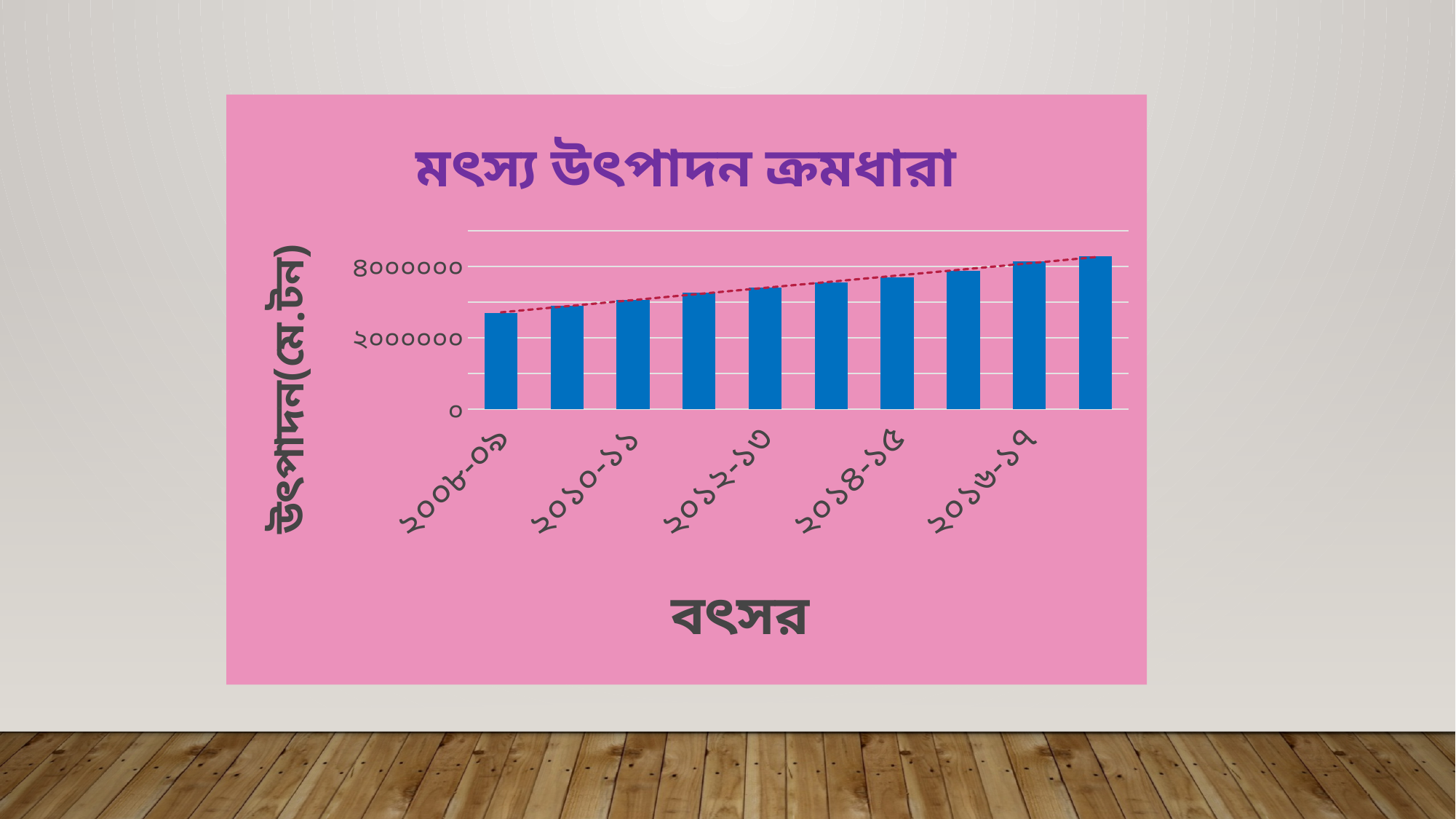
Which is larger, the value for ২০১৬-১৭ or the value for ২০০৮-০৯? ২০১৬-১৭ Which bar is the lowest in the chart? ২০০৮-০৯ Do the values rise or fall from left to right along the x axis? Rise What kind of chart is shown on the slide? Bar chart Is the value for ২০১৪-১৫ greater or less than ৪০০০০০০? less Is the value for ২০১০-১১ greater or less than ২০০০০০০? greater What is the title of the chart? মৎস্য উৎপাদন ক্রমধারা What is the label of the x axis? বৎসর Which bar is the highest in the chart? The rightmost bar Is the value for ২০০৮-০৯ greater or less than ২০০০০০০? greater How many bars are plotted in the chart? 10